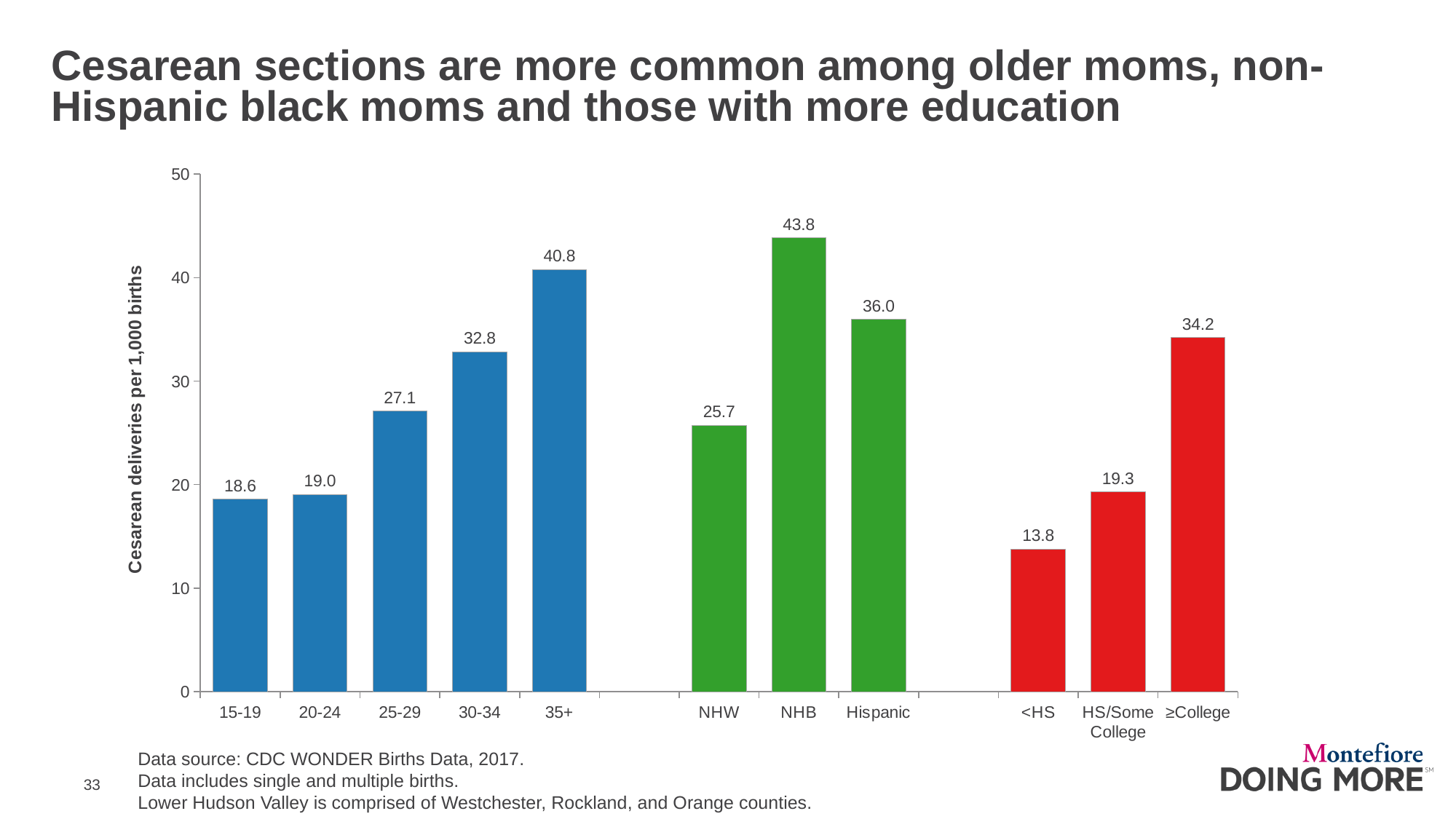
Do the values rise or fall across the age groups from 15-19 to 35+? rise What is the value for NHB? 43.8 What is the difference between the values for NHB and Hispanic? 7.8 How many bars are plotted on the chart? 11 What is the value for the 35+ age group? 40.8 Which category has the highest value on the chart? NHB What is the difference between the values for 35+ and 15-19? 22.2 Is the value for NHW greater or less than 30? less What kind of chart is shown on the slide? bar chart Which is larger, the value for ≥College or the value for 30-34? ≥College What is the value for <HS? 13.8 Which category has the lowest value on the chart? <HS